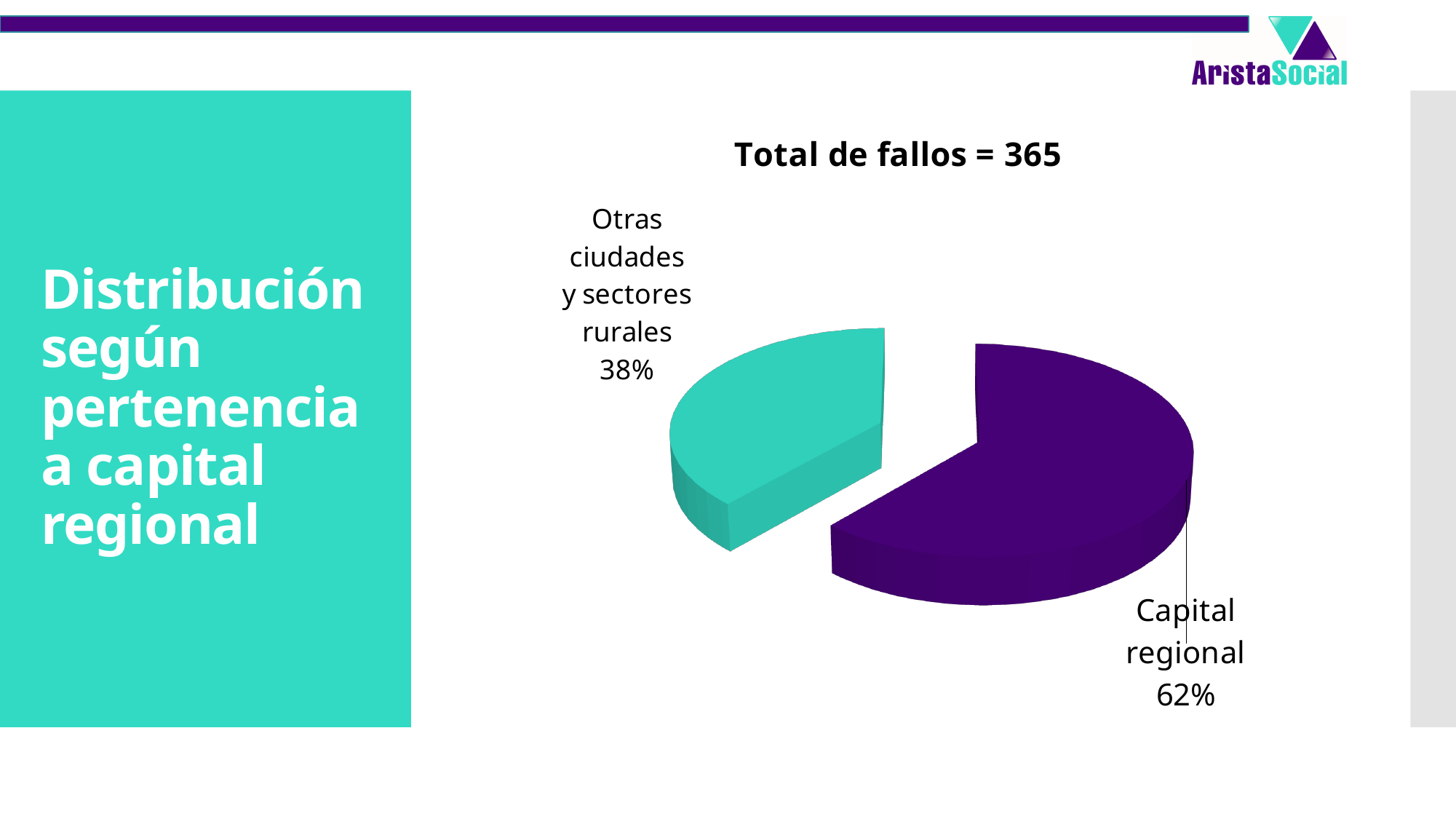
What is the difference in percentage points between Capital regional and Otras ciudades y sectores rurales? 24 percentage points Which category has the largest slice of the pie? Capital regional Which is larger, the share for Capital regional or the share for Otras ciudades y sectores rurales? Capital regional What colour is the Capital regional slice? Purple What share of the pie does Capital regional represent? 62% What kind of chart is shown on the slide? Pie chart What is the total number of fallos stated in the chart title? 365 Which category has the smallest slice of the pie? Otras ciudades y sectores rurales How many slices does the pie chart have? 2 What share of the pie does Otras ciudades y sectores rurales represent? 38% What is the title of the chart? Total de fallos = 365